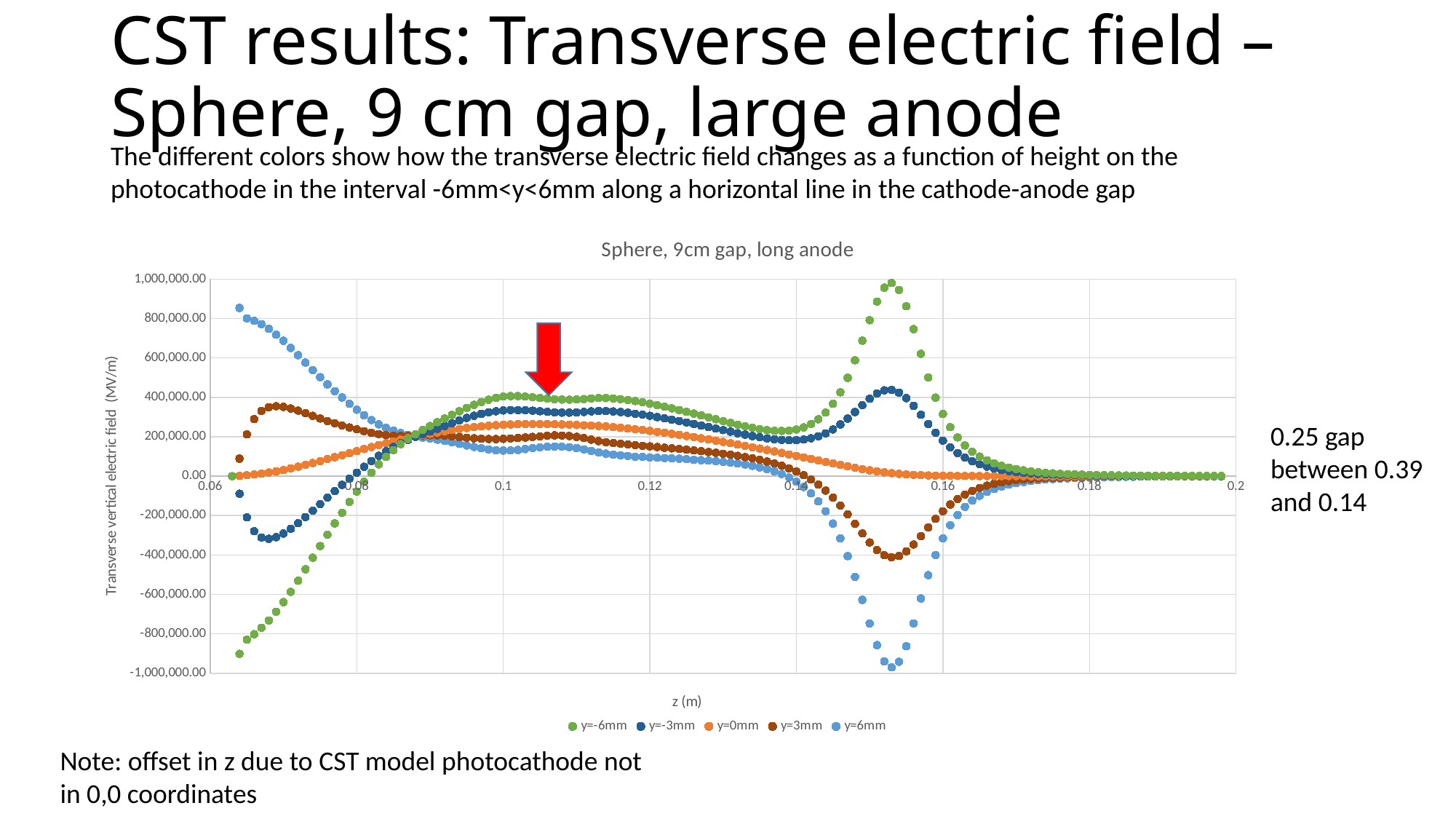
Is the peak value of the y=3mm series near z=0.07 greater or less than 200,000.00? greater At z=0.1, which series has the larger value, y=-6mm or y=0mm? y=-6mm What kind of chart is shown on the slide? scatter chart Is the minimum value of the y=6mm series near z=0.15 greater or less than -800,000.00? less Which series reaches the highest value on the chart? y=-6mm Does the y=6mm series rise or fall between z=0.06 and z=0.08? fall What is the title of the chart? Sphere, 9cm gap, long anode Is the peak value of the y=-6mm series near z=0.15 greater or less than 800,000.00? greater How many series does the legend list? 5 What is the label of the x axis? z (m)